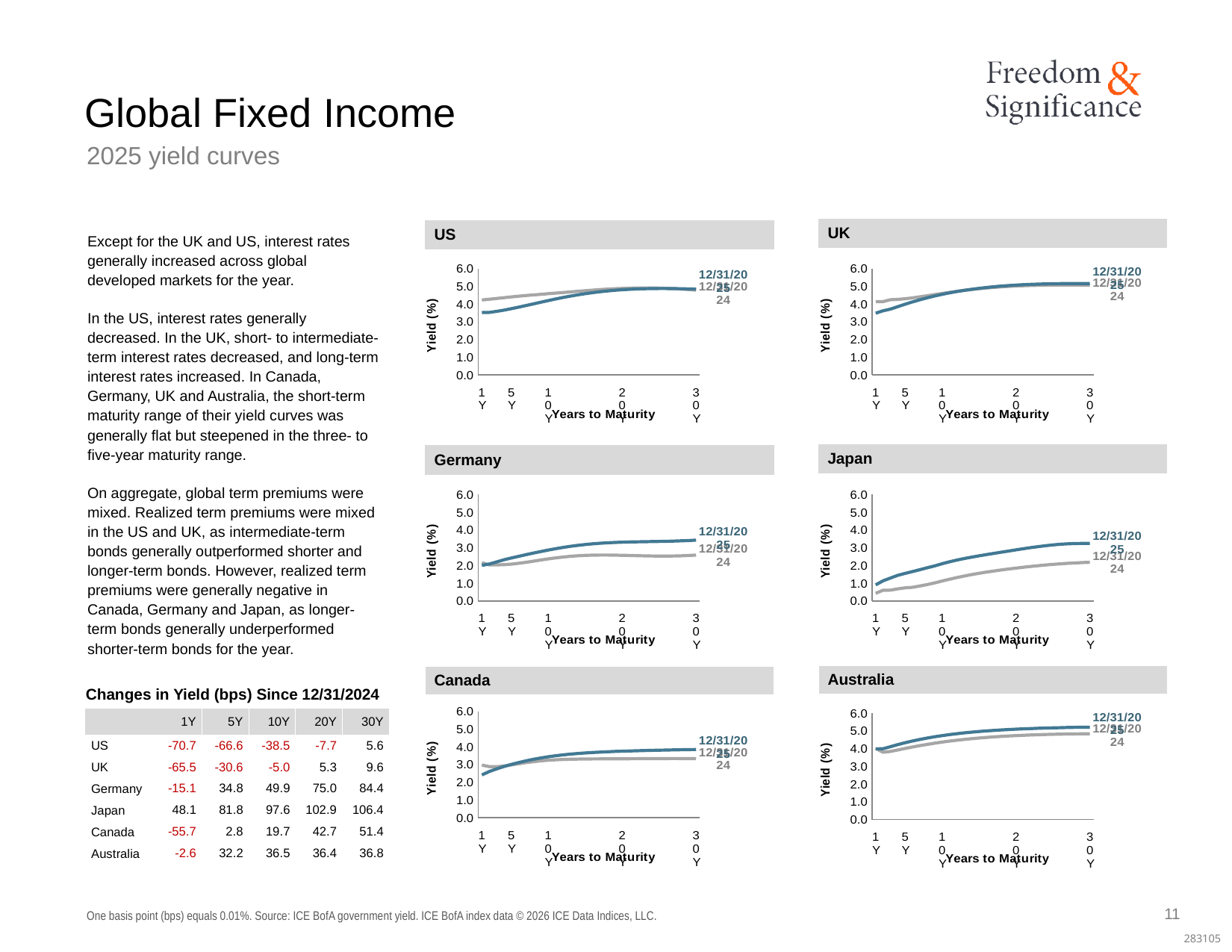
How many maturity points are plotted along the x axis of the Canada chart? 5 In the US chart, is the 12/31/2025 value at 1Y greater or less than 3.0? greater What kind of chart is the US chart? line chart What is the x-axis title of the Australia chart? Years to Maturity In the Germany chart, does the 12/31/2025 line rise or fall from 1Y to 30Y? rise In the Japan chart, is the 12/31/2024 value at 1Y greater or less than 1.0? less In the Canada chart, is the 12/31/2025 value at 1Y greater or less than 3.0? less In the Japan chart, which series has the higher value at 30Y, 12/31/2025 or 12/31/2024? 12/31/2025 In the US chart, which series has the higher value at 1Y, 12/31/2025 or 12/31/2024? 12/31/2024 In the Japan chart, does the 12/31/2025 line rise or fall from 1Y to 30Y? rise How many series does the legend of the Japan chart list? 2